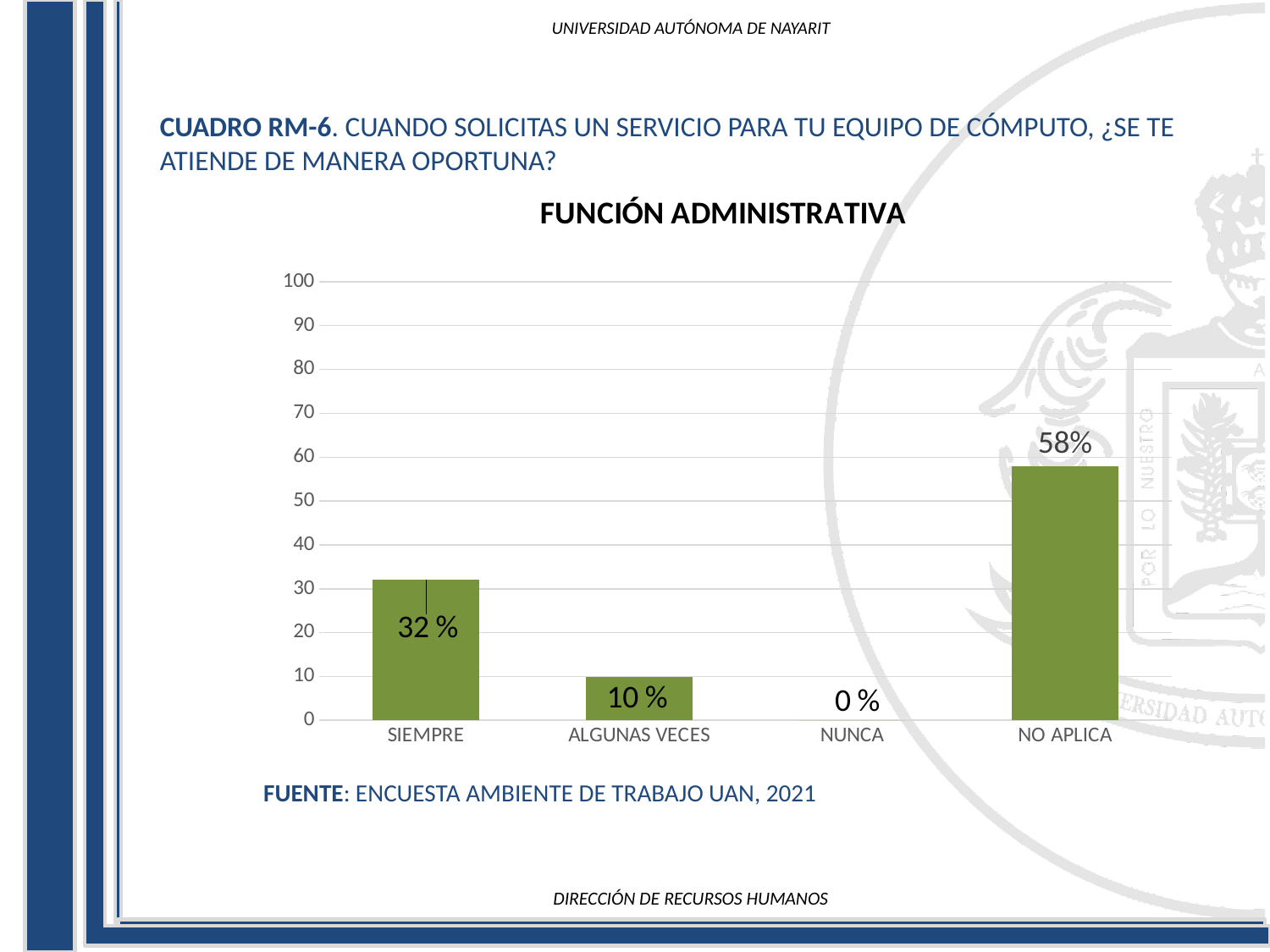
Which category has the lowest value? NUNCA What is the value for ALGUNAS VECES? 10 % What is the value for SIEMPRE? 32 % What kind of chart is shown on the slide? bar chart What is the difference between the values for NO APLICA and SIEMPRE? 26 What is the value for NUNCA? 0 % How many categories are shown on the x axis? 4 Which is larger, the value for SIEMPRE or the value for ALGUNAS VECES? SIEMPRE Which category has the highest value? NO APLICA What is the value for NO APLICA? 58% Is the value for NO APLICA greater or less than 50? greater What is the title of the chart? FUNCIÓN ADMINISTRATIVA